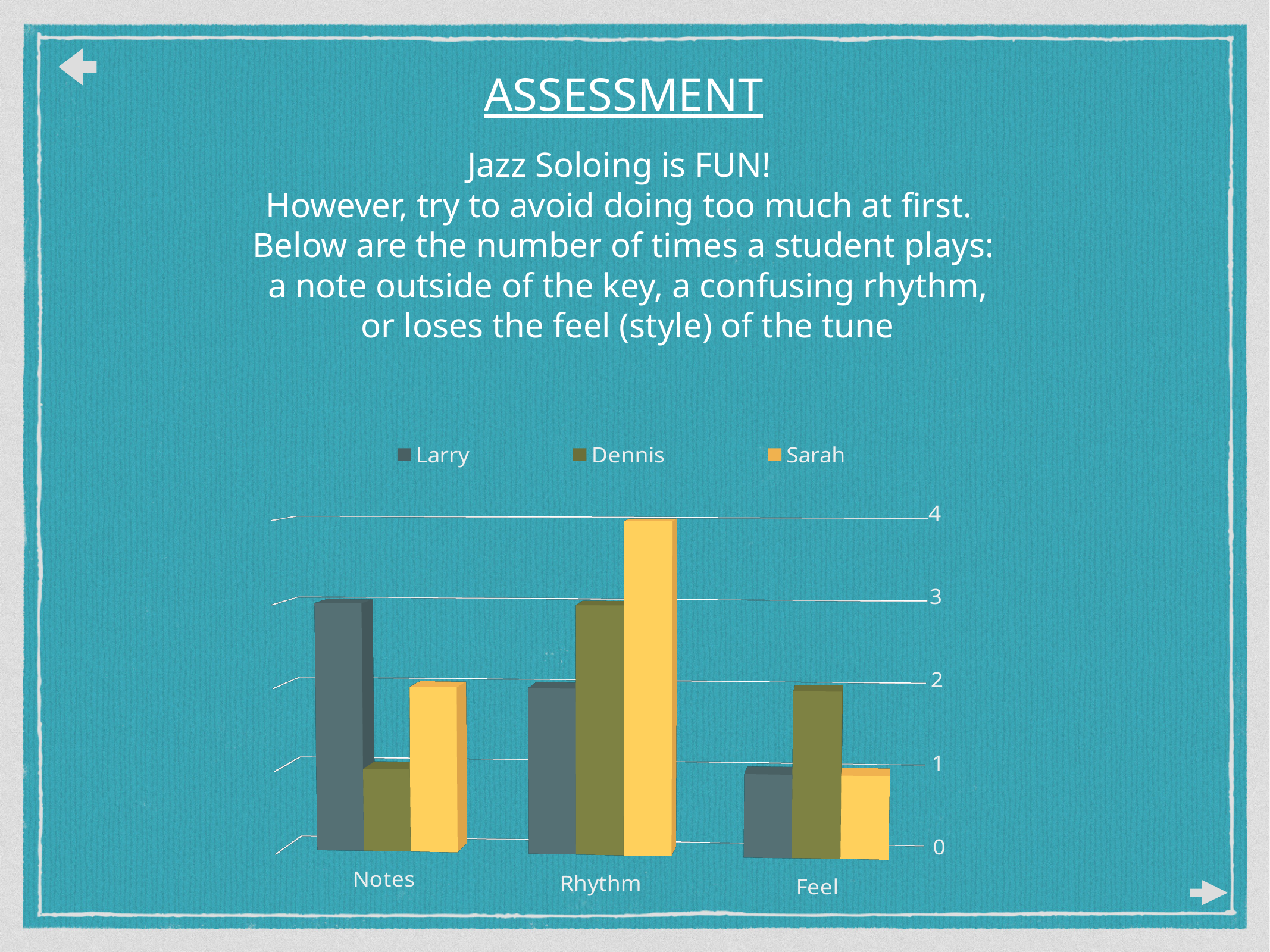
Do Larry's values rise or fall from Notes to Rhythm to Feel? fall Which series has the tallest bar in the Rhythm category? Sarah What is the value for Sarah in the Rhythm category? 4 How many series does the legend list? 3 Is the value for Larry in the Feel category greater or less than 2? less Which series has the tallest bar in the Notes category? Larry How many categories are shown on the x axis? 3 Which series has the shortest bar in the Notes category? Dennis Is the value for Dennis in the Rhythm category greater or less than 2? greater Which series has the tallest bar in the Feel category? Dennis What kind of chart is shown on the slide? bar chart What is the value for Larry in the Notes category? 3